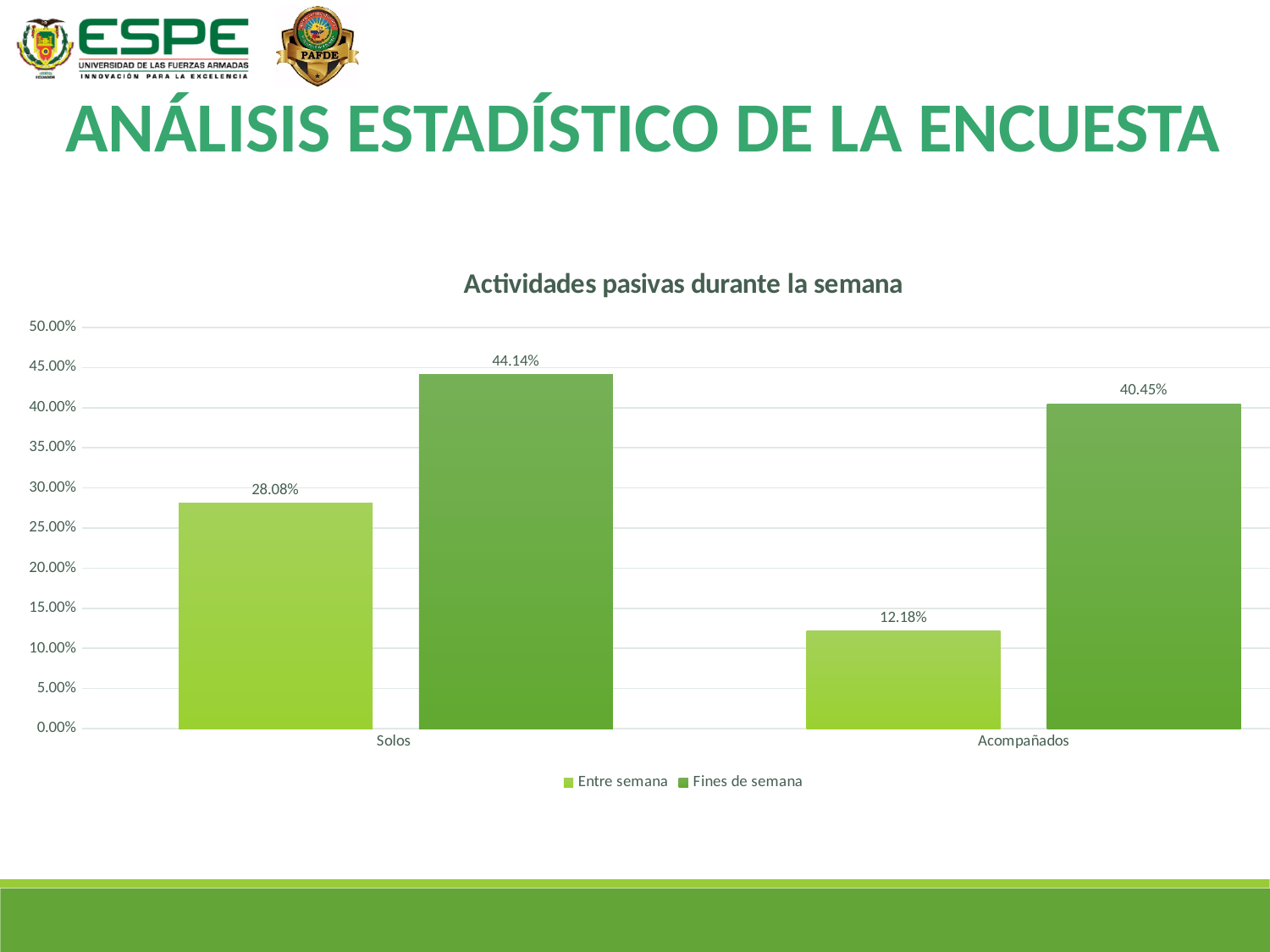
What is the title of the chart? Actividades pasivas durante la semana What is the value for Entre semana in the Solos category? 28.08% How many categories are shown on the x axis? 2 How many series does the legend list? 2 Which bar has the lowest value in the chart? Entre semana, Acompañados What is the difference between the Fines de semana and Entre semana values for Solos? 16.06% What is the value for Fines de semana in the Solos category? 44.14% What is the value for Entre semana in the Acompañados category? 12.18% What is the value for Fines de semana in the Acompañados category? 40.45% What is the difference between the Fines de semana values for Solos and Acompañados? 3.69% Which is larger: Entre semana for Solos or Entre semana for Acompañados? Entre semana for Solos Which bar has the highest value in the chart? Fines de semana, Solos